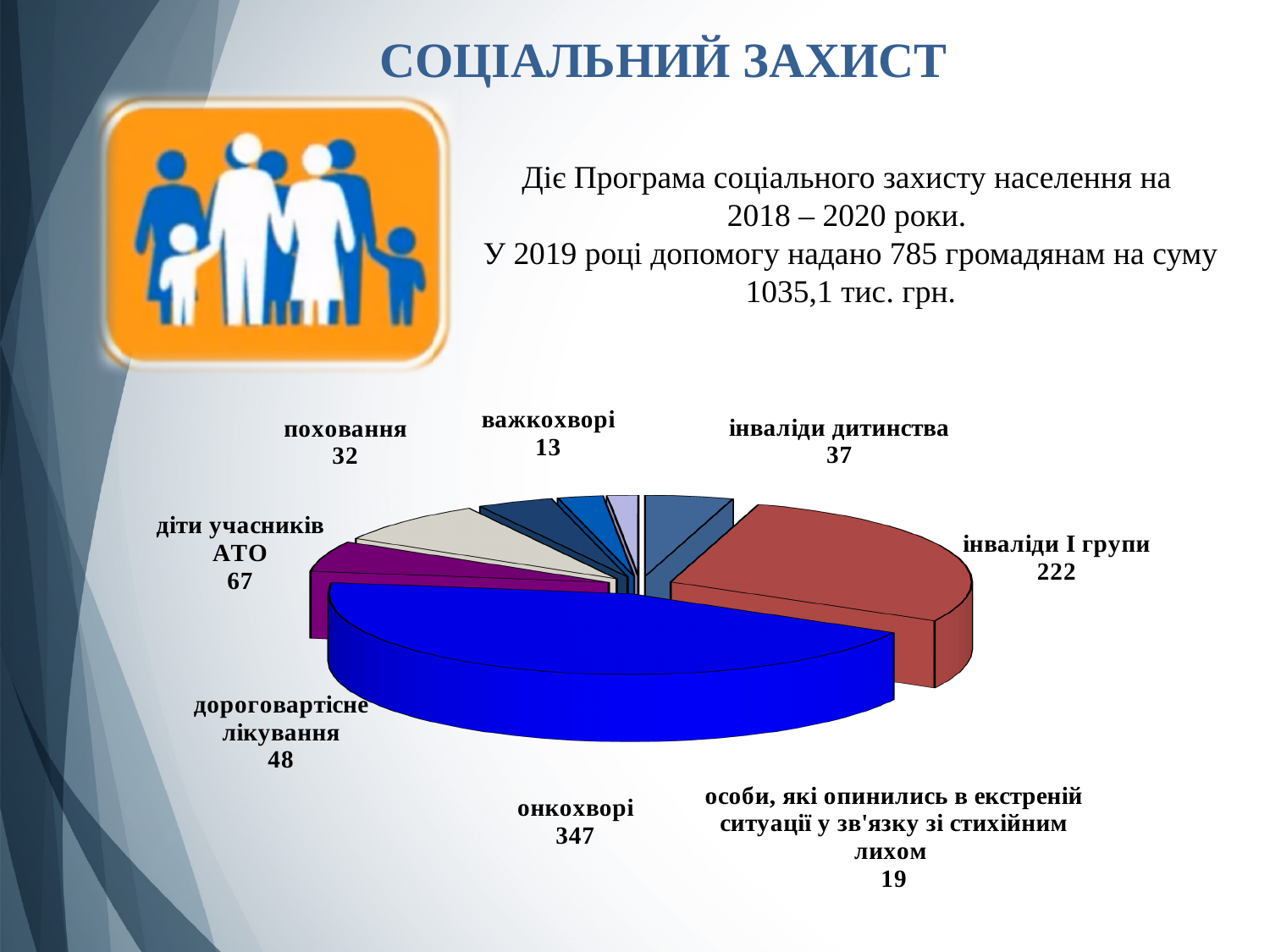
How many categories does the pie chart show? 8 What is the value for онкохворі in the pie chart? 347 What is the difference between the values for онкохворі and інваліди І групи? 125 What is the value for діти учасників АТО in the pie chart? 67 What is the total of all the values shown in the pie chart? 785 Which category has the smallest slice in the pie chart? важкохворі What type of chart is shown on the slide? pie chart Which is larger: the value for поховання or the value for інваліди дитинства? інваліди дитинства What is the value for інваліди І групи in the pie chart? 222 Which category has the largest slice in the pie chart? онкохворі What is the value for особи, які опинились в екстреній ситуації у зв'язку зі стихійним лихом? 19 What is the value for важкохворі in the pie chart? 13